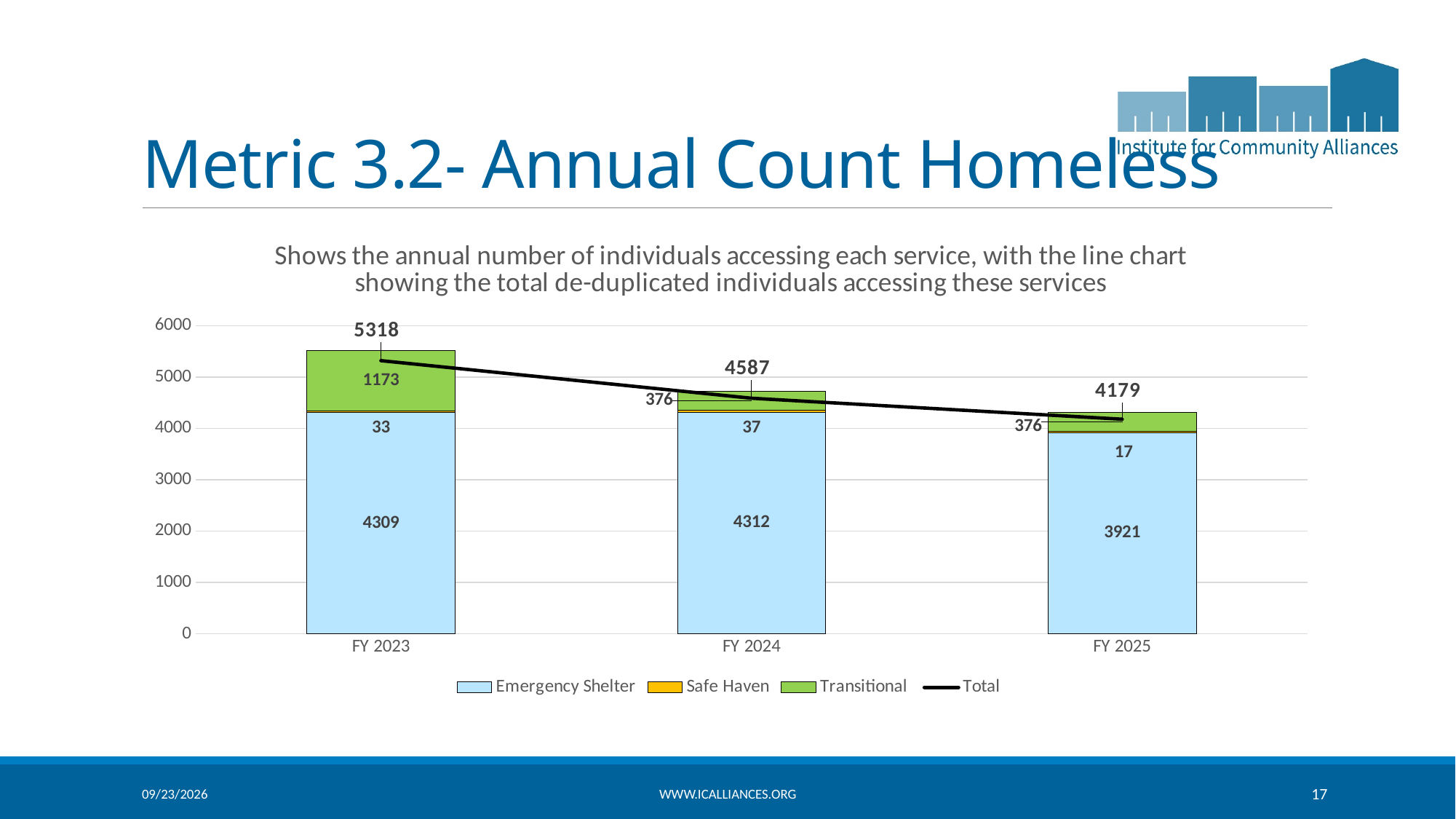
Which fiscal year has the lowest Emergency Shelter value? FY 2025 What is the difference between the Total value for FY 2023 and the Total value for FY 2025? 1139 Which is larger, the Emergency Shelter value for FY 2023 or for FY 2024? FY 2024 What is the Safe Haven value for FY 2025? 17 What kind of chart is shown on the slide? stacked bar chart with a line What is the Total value shown on the line for FY 2024? 4587 How many fiscal years are shown on the x axis? 3 Which fiscal year has the highest Total value? FY 2023 What is the Emergency Shelter value for FY 2023? 4309 Does the Total line rise or fall from FY 2023 to FY 2025? fall What is the Transitional value for FY 2023? 1173 How many series does the legend list? 4